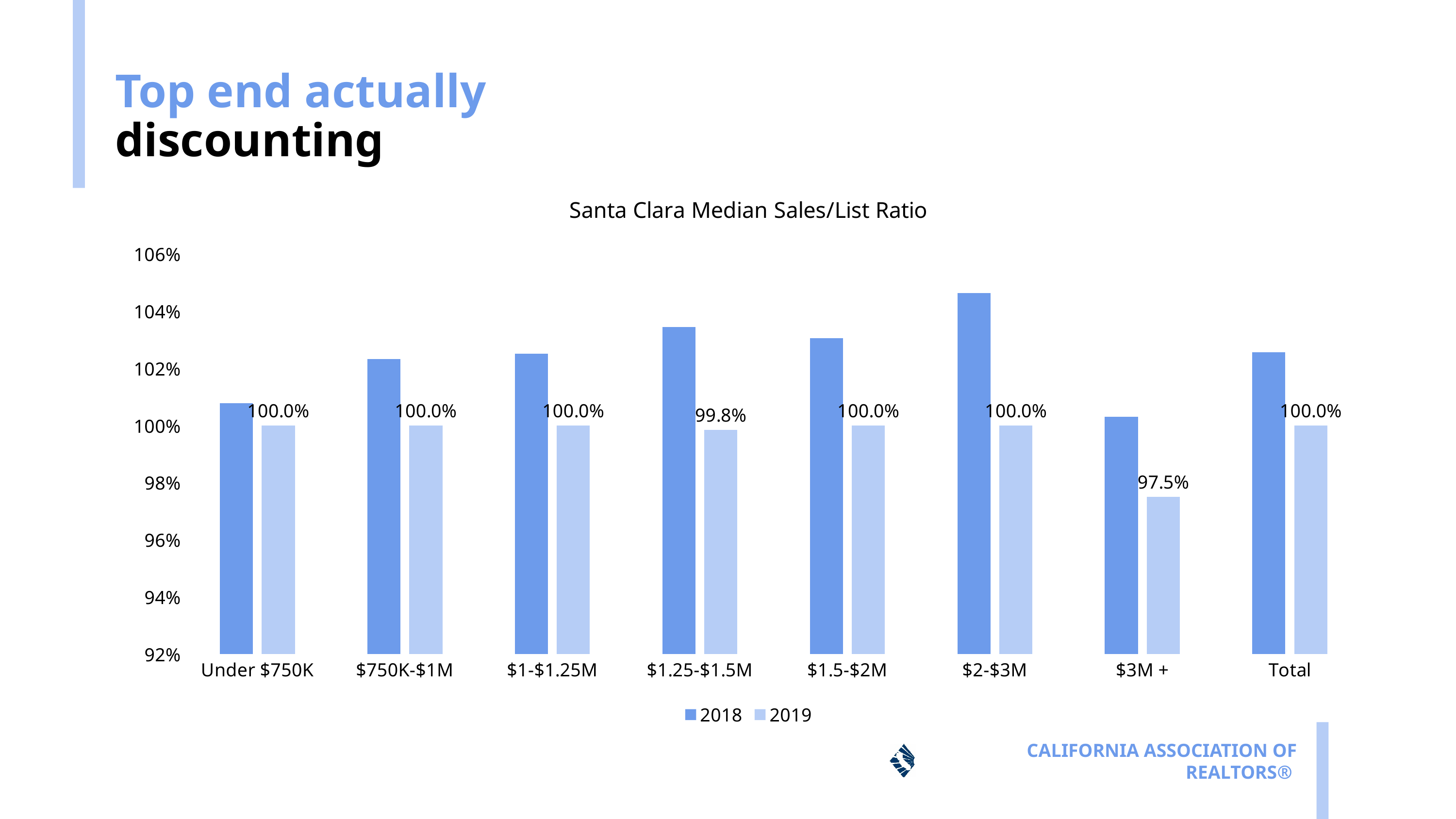
How many series does the legend list? 2 Which price range has the highest 2018 value? $2-$3M Is the 2018 value for $3M + greater or less than 102%? less What is the 2019 value for $3M + in the Santa Clara Median Sales/List Ratio chart? 97.5% What kind of chart is shown on the slide? bar chart For $1.25-$1.5M, which series has the larger value, 2018 or 2019? 2018 What is the 2019 value for $1.25-$1.5M? 99.8% What is the difference between the 2019 value for Total and the 2019 value for $3M +? 2.5% Is the 2018 value for $2-$3M greater or less than 104%? greater Which price range has the lowest 2019 value? $3M + Which is larger: the 2019 value for $1.25-$1.5M or the 2019 value for $3M +? $1.25-$1.5M How many categories are shown on the x axis of the chart? 8